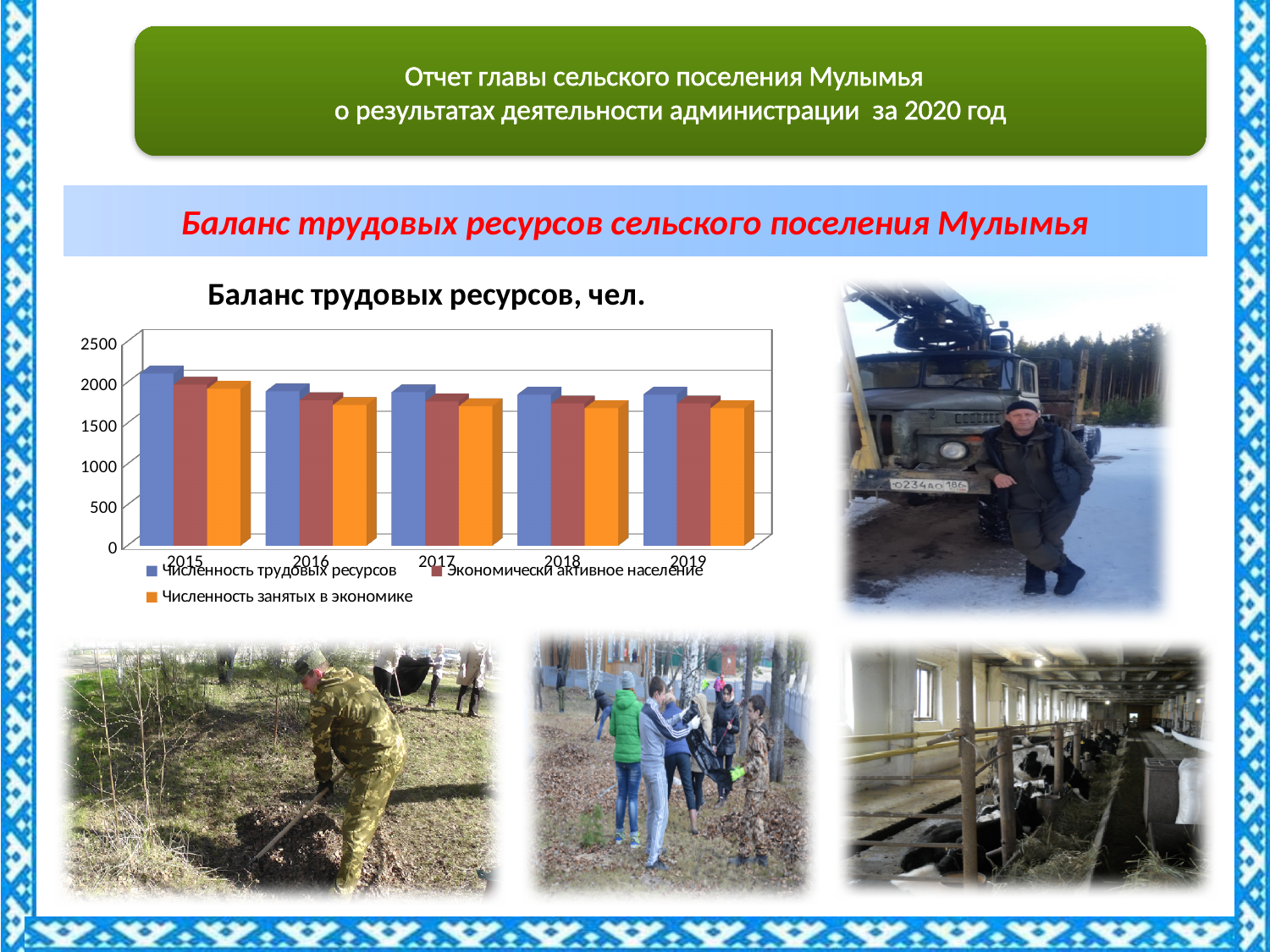
Is the value for Численность занятых в экономике in 2019 greater or less than 1500? greater Is the value for Численность трудовых ресурсов in 2016 greater or less than 2000? less What is the title of the chart? Баланс трудовых ресурсов, чел. In 2015, which is larger: Численность трудовых ресурсов or Численность занятых в экономике? Численность трудовых ресурсов Is the value for Численность трудовых ресурсов in 2015 greater or less than 2000? greater Which series is shown in orange in the chart? Численность занятых в экономике Does Численность трудовых ресурсов rise or fall from 2015 to 2019? fall What kind of chart is shown on the slide? bar chart How many years are shown on the x axis of the chart? 5 How many series does the chart legend list? 3 In which year is Численность трудовых ресурсов the highest? 2015